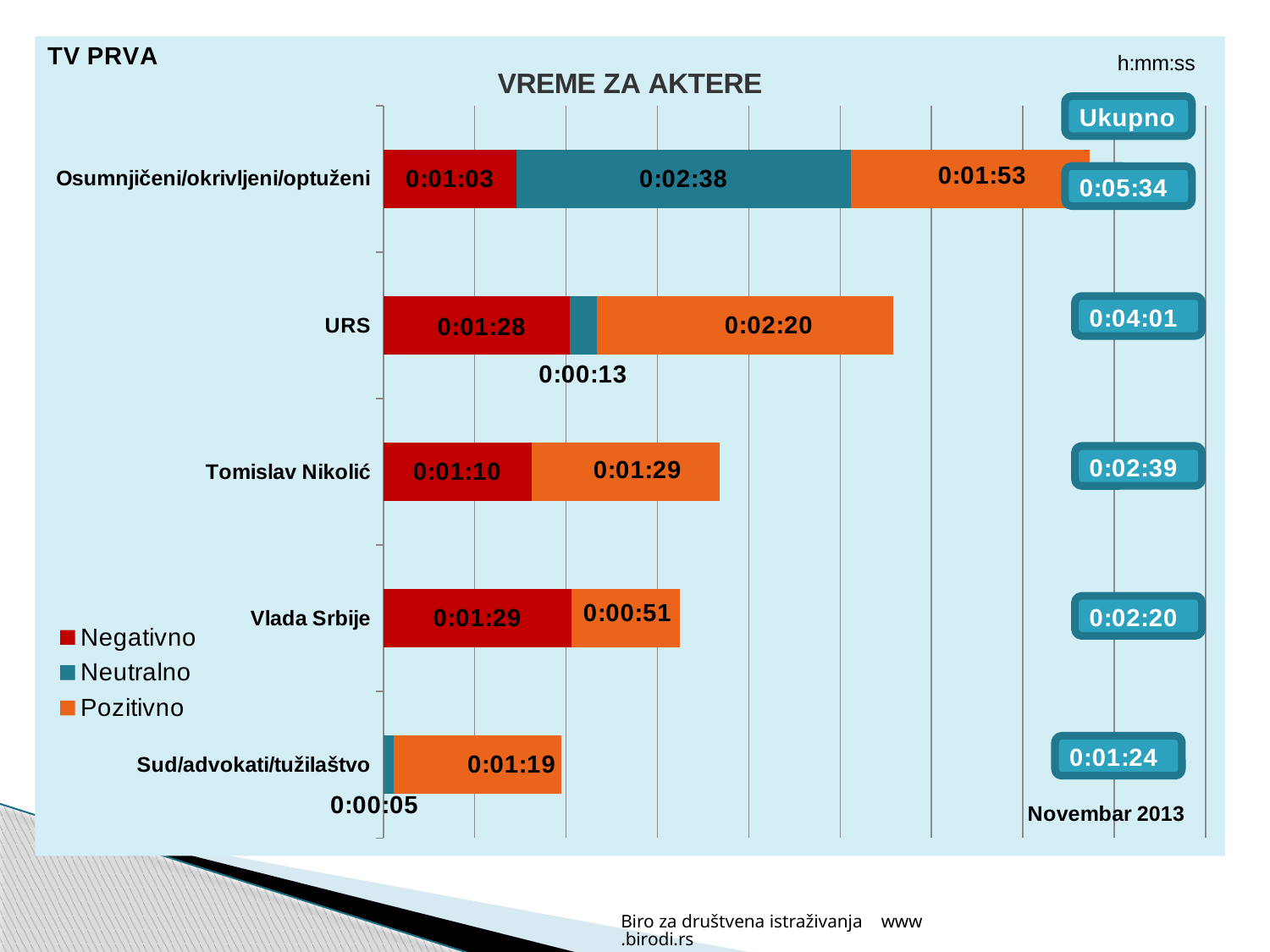
What is the difference between the Pozitivno value for Tomislav Nikolić and the Pozitivno value for Vlada Srbije? 0:00:38 How many categories (actors) are shown on the chart? 5 How many series does the legend list? 3 What is the Pozitivno value for URS? 0:02:20 What is the Negativno value for Vlada Srbije? 0:01:29 What kind of chart is shown on the slide? Stacked bar chart Which category has the lowest total (Ukupno) time? Sud/advokati/tužilaštvo What is the total (Ukupno) time shown for URS? 0:04:01 What is the Neutralno value for Sud/advokati/tužilaštvo? 0:00:05 What is the Neutralno value for Osumnjičeni/okrivljeni/optuženi? 0:02:38 Which category has the highest total (Ukupno) time? Osumnjičeni/okrivljeni/optuženi Which is larger: the Negativno value for URS or the Negativno value for Tomislav Nikolić? URS